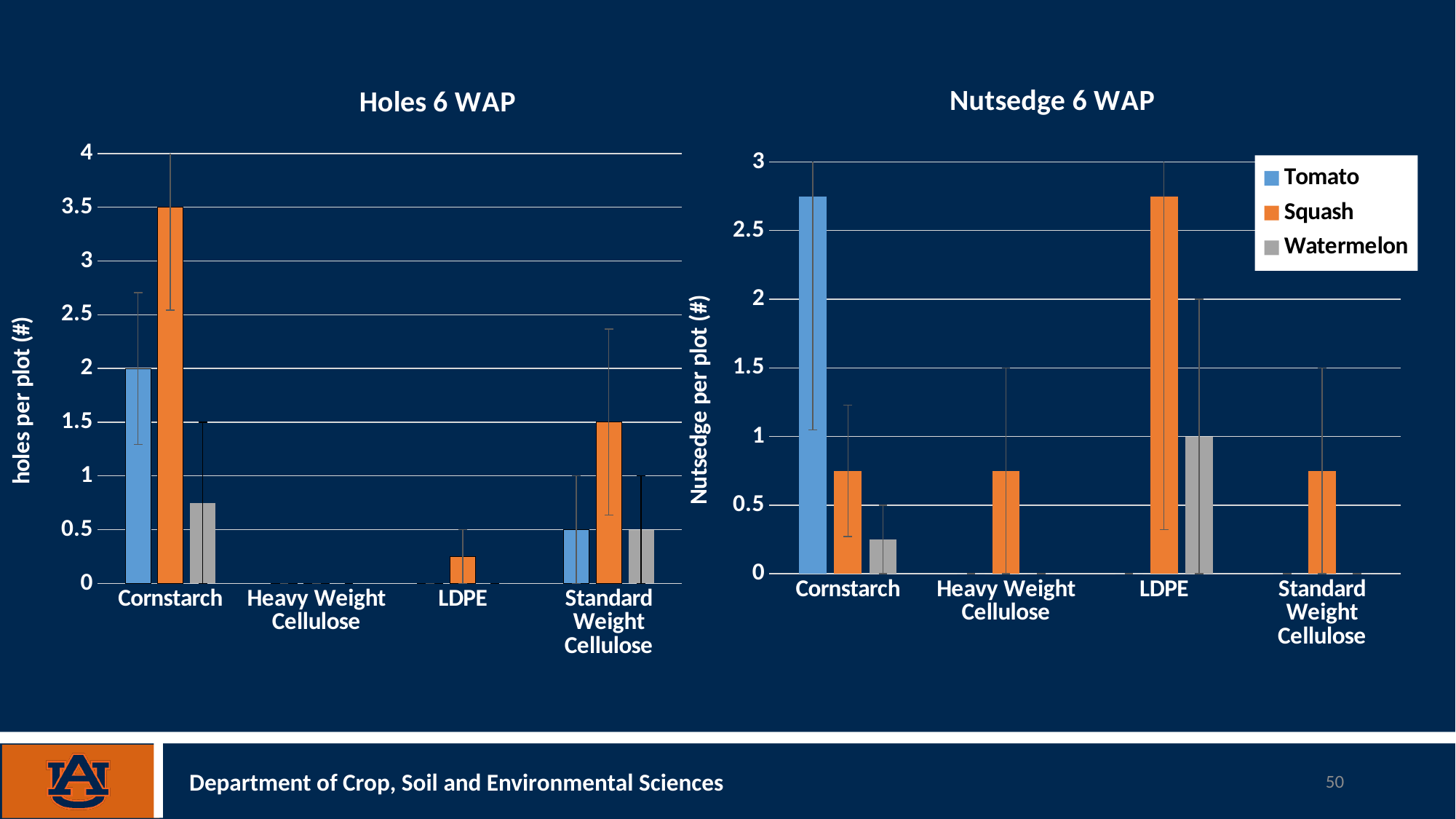
In the 'Holes 6 WAP' chart, which category has the highest Squash value? Cornstarch In the 'Holes 6 WAP' chart, which category has the lowest Squash value? Heavy Weight Cellulose What kind of chart is the 'Holes 6 WAP' chart? bar chart In the 'Nutsedge 6 WAP' chart, for Cornstarch, which is larger: the Tomato value or the Squash value? Tomato In the 'Nutsedge 6 WAP' chart, is the Tomato value for Cornstarch greater or less than 2.5? greater What is the y-axis title of the 'Nutsedge 6 WAP' chart? Nutsedge per plot (#) In the 'Holes 6 WAP' chart, how many mulch categories are shown on the x axis? 4 In the 'Nutsedge 6 WAP' chart, is the Squash value for LDPE greater or less than 2? greater In the 'Holes 6 WAP' chart, is the Squash value for Cornstarch greater or less than 3? greater In the 'Holes 6 WAP' chart, what is the Tomato value for Cornstarch? 2 How many series does the legend on the slide list? 3